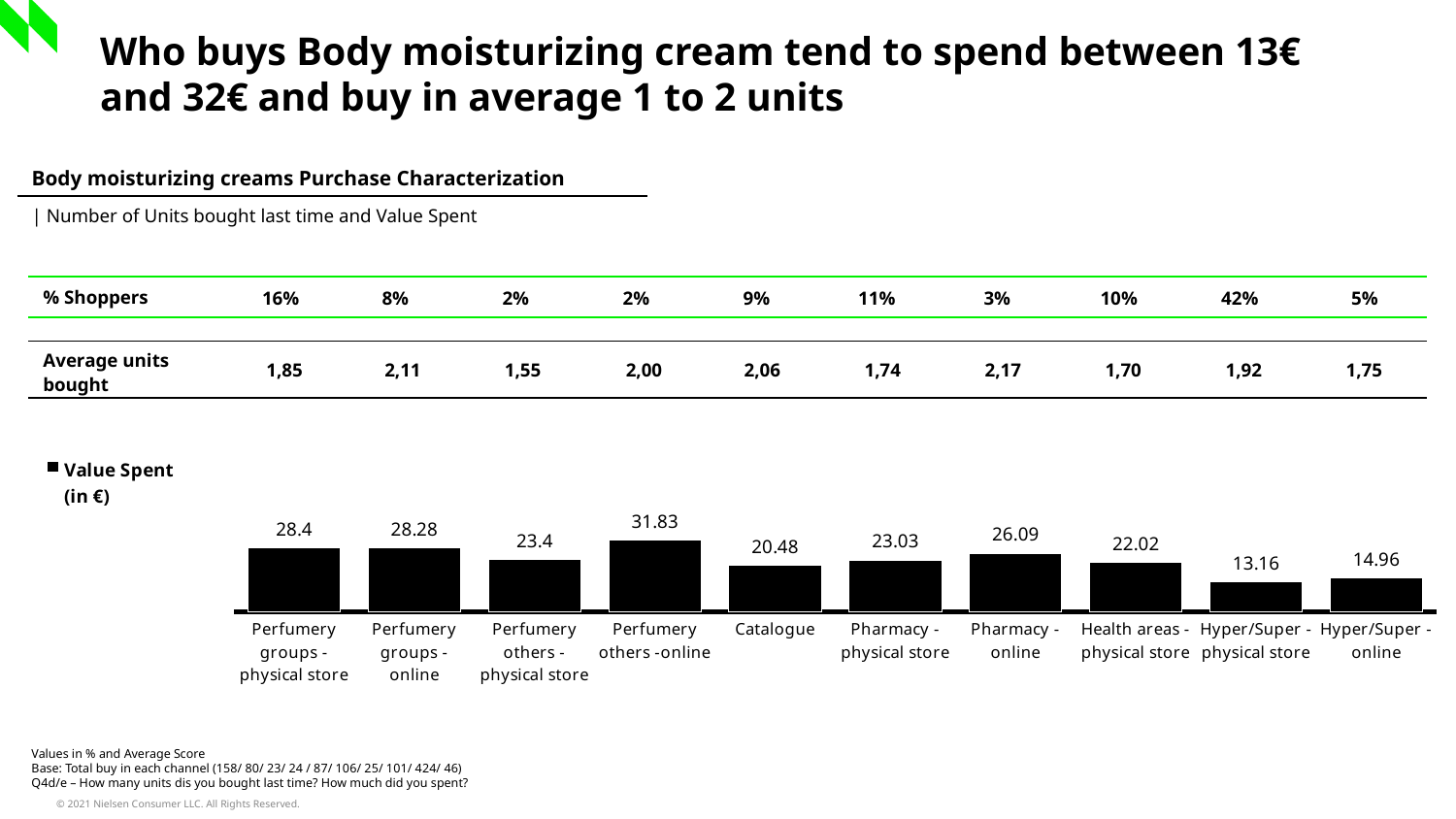
What is the Value Spent (in €) for Perfumery others - online? 31.83 Which channel has the highest Value Spent (in €)? Perfumery others - online What is the difference in Value Spent (in €) between Pharmacy - online and Catalogue? 5.61 What is the Value Spent (in €) for Catalogue? 20.48 What is the difference in Value Spent (in €) between Perfumery others - online and Hyper/Super - physical store? 18.67 What kind of chart is used to show Value Spent (in €)? Bar chart How many channels are shown in the Value Spent chart? 10 Which has a higher Value Spent (in €): Pharmacy - online or Health areas - physical store? Pharmacy - online Which channel has the lowest Value Spent (in €)? Hyper/Super - physical store How many series does the legend of the Value Spent chart list? 1 What is the Value Spent (in €) for Hyper/Super - online? 14.96 What is the Value Spent (in €) for Pharmacy - physical store? 23.03